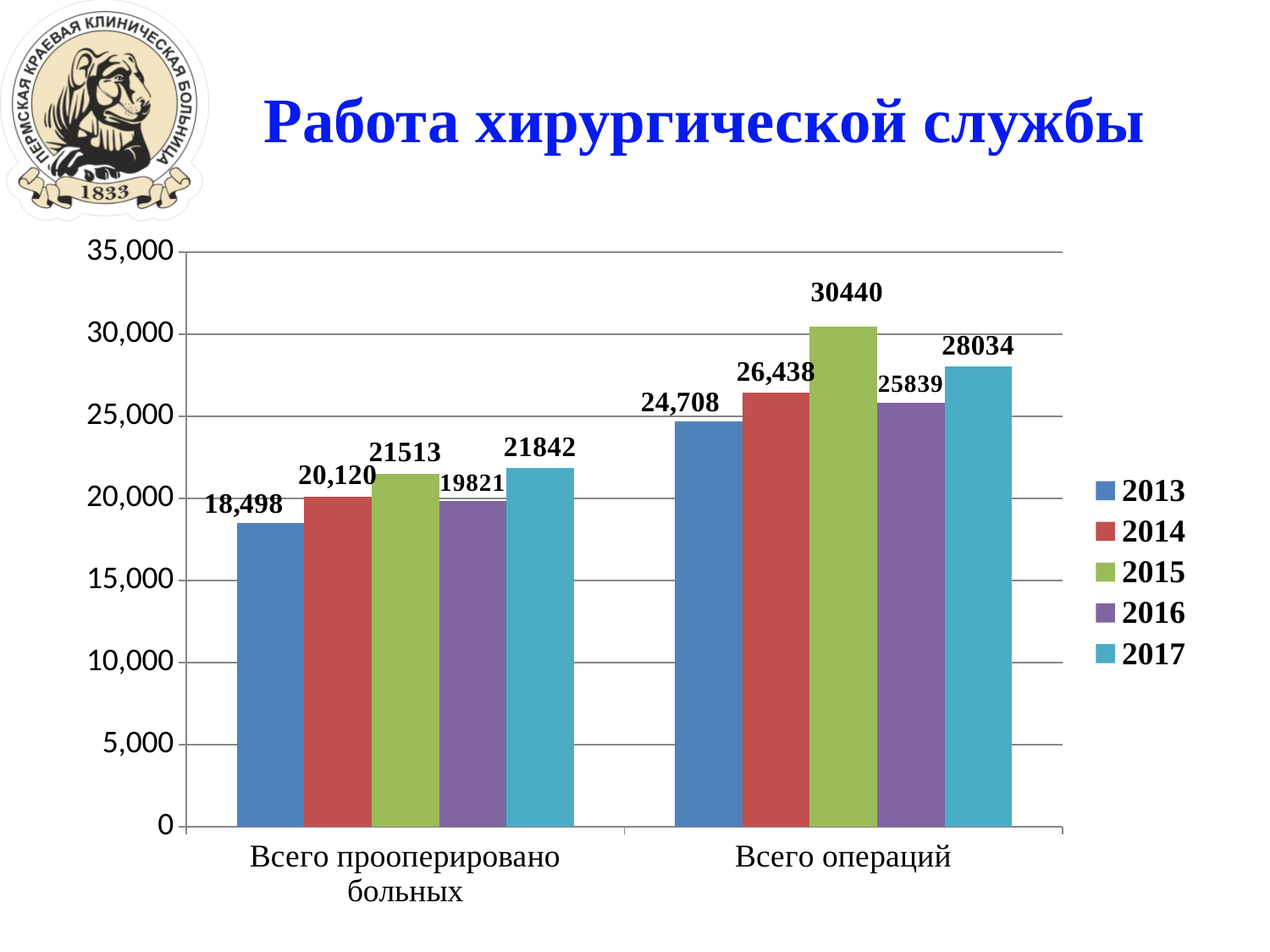
Which is larger in the "Всего прооперировано больных" category: the value for 2014 or the value for 2016? 2014 Which year has the lowest value in the "Всего прооперировано больных" category? 2013 What is the value for 2015 in the "Всего операций" category? 30440 What kind of chart is shown on the slide? Bar chart What is the value for 2016 in the "Всего операций" category? 25839 What is the title of the slide above the chart? Работа хирургической службы What is the value for 2013 in the "Всего прооперировано больных" category? 18,498 What is the value for 2017 in the "Всего прооперировано больных" category? 21842 How many series does the legend list? 5 What is the difference between the 2017 and 2016 values in the "Всего операций" category? 2195 Is the value for 2014 in the "Всего операций" category greater or less than 25,000? greater Which year has the highest value in the "Всего операций" category? 2015